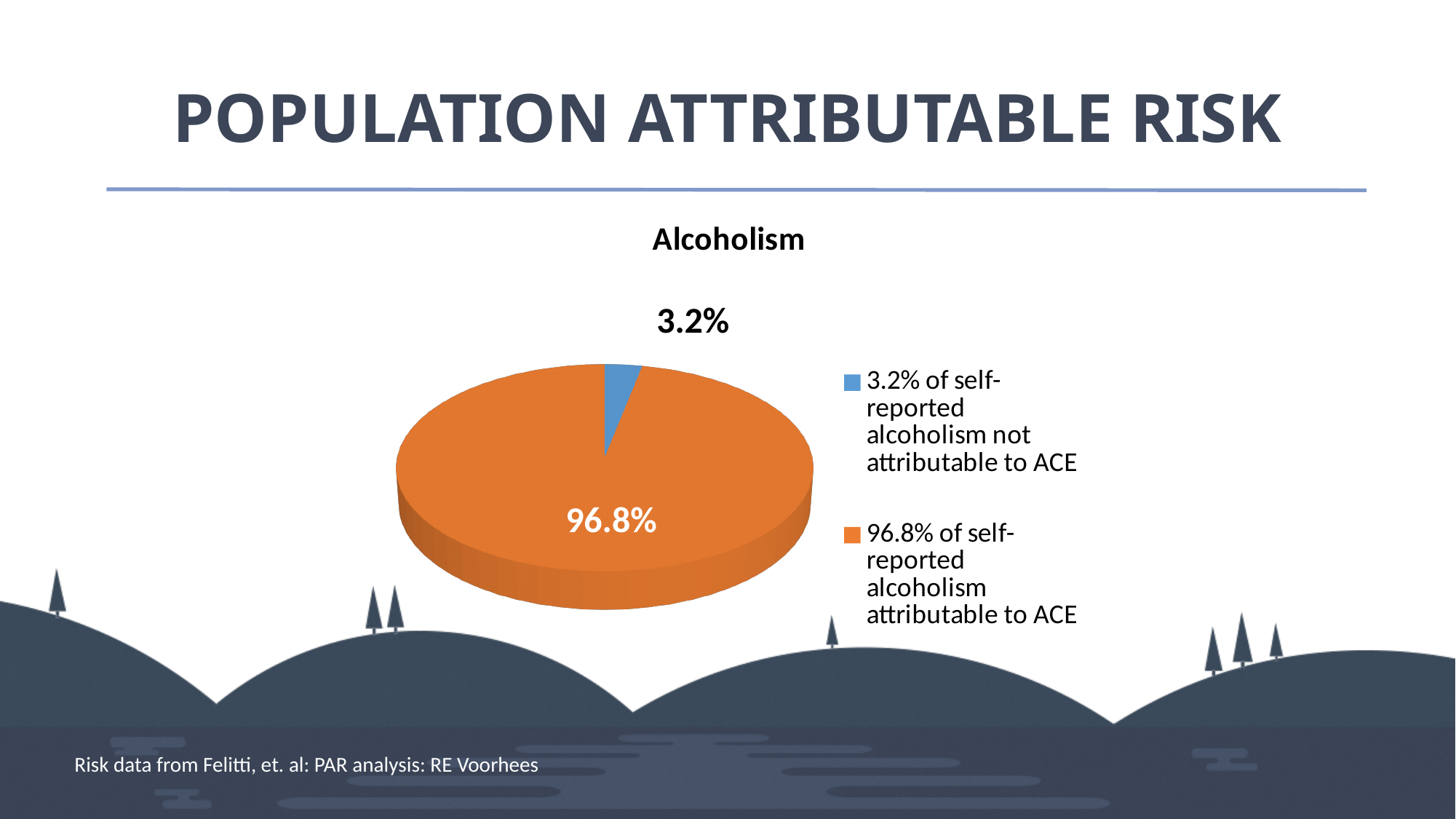
Which is larger: the share attributable to ACE or the share not attributable to ACE? The share attributable to ACE What type of chart is shown on the slide? Pie chart What is the total of the two slices shown in the pie chart? 100% Which slice of the pie is the largest? 96.8% of self-reported alcoholism attributable to ACE What share of self-reported alcoholism is attributable to ACE according to the chart? 96.8% What is the difference between the two slices of the pie? 93.6% Which slice of the pie is the smallest? 3.2% of self-reported alcoholism not attributable to ACE How many slices does the pie chart have? 2 How many entries does the legend list? 2 What share of self-reported alcoholism is not attributable to ACE according to the chart? 3.2% What colour is the slice representing alcoholism attributable to ACE? Orange What is the title of the chart? Alcoholism